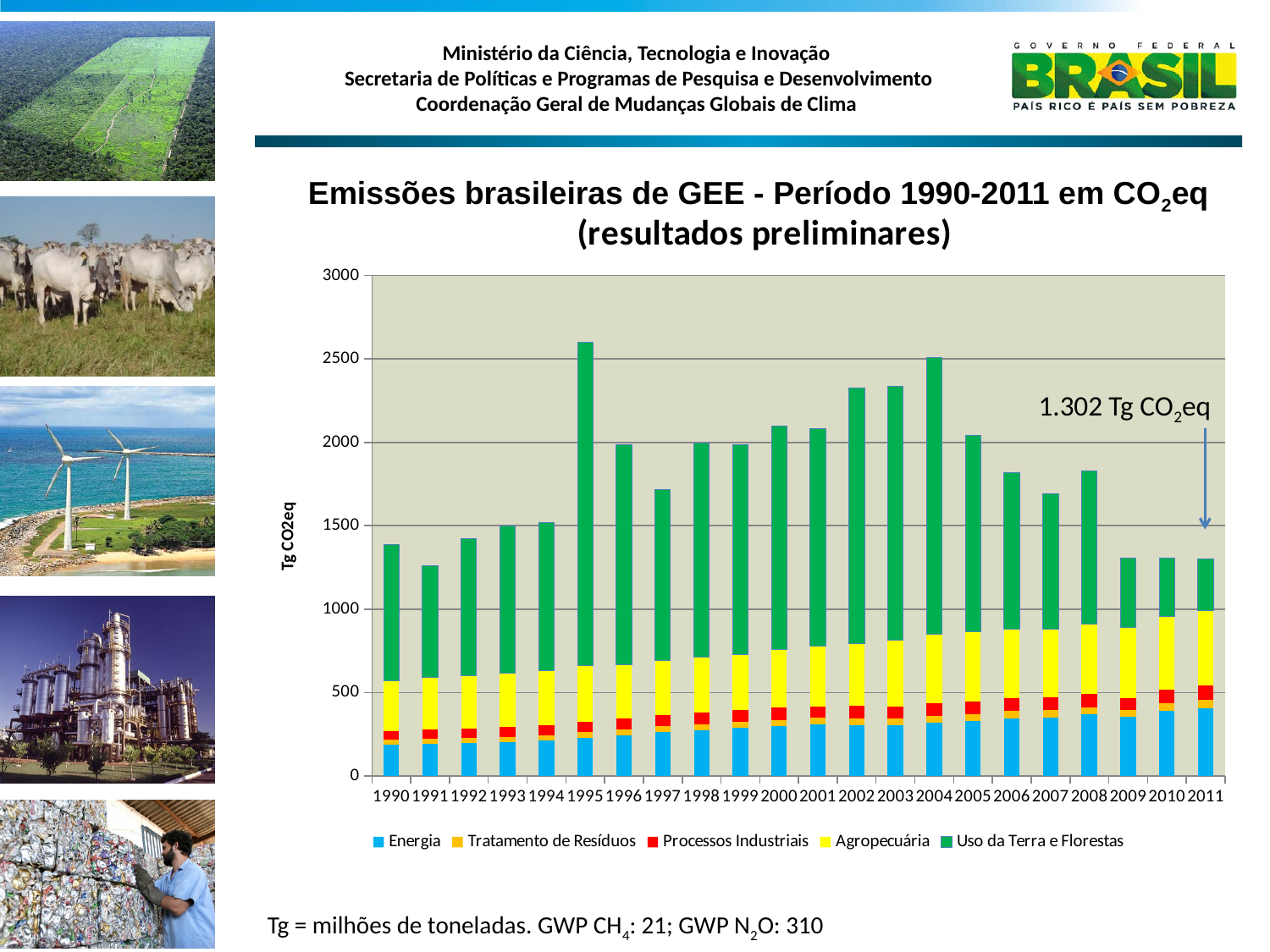
What kind of chart is shown on the slide? Stacked bar chart What total emissions value is annotated for 2011 on the chart? 1.302 Tg CO2eq Do the total emissions rise or fall from 2004 to 2007? Fall Which series is shown in green in the chart? Uso da Terra e Florestas Is the total value for 1997 greater or less than 2000? less Is the total value for 1995 greater or less than 2500? greater Which year has the highest total emissions in the chart? 1995 How many series does the chart legend list? 5 How many years are shown along the x axis of the chart? 22 Which year has the larger total emissions, 2006 or 2007? 2006 Is the total value for 1990 greater or less than 1500? less Which year has the larger total emissions, 1995 or 2004? 1995